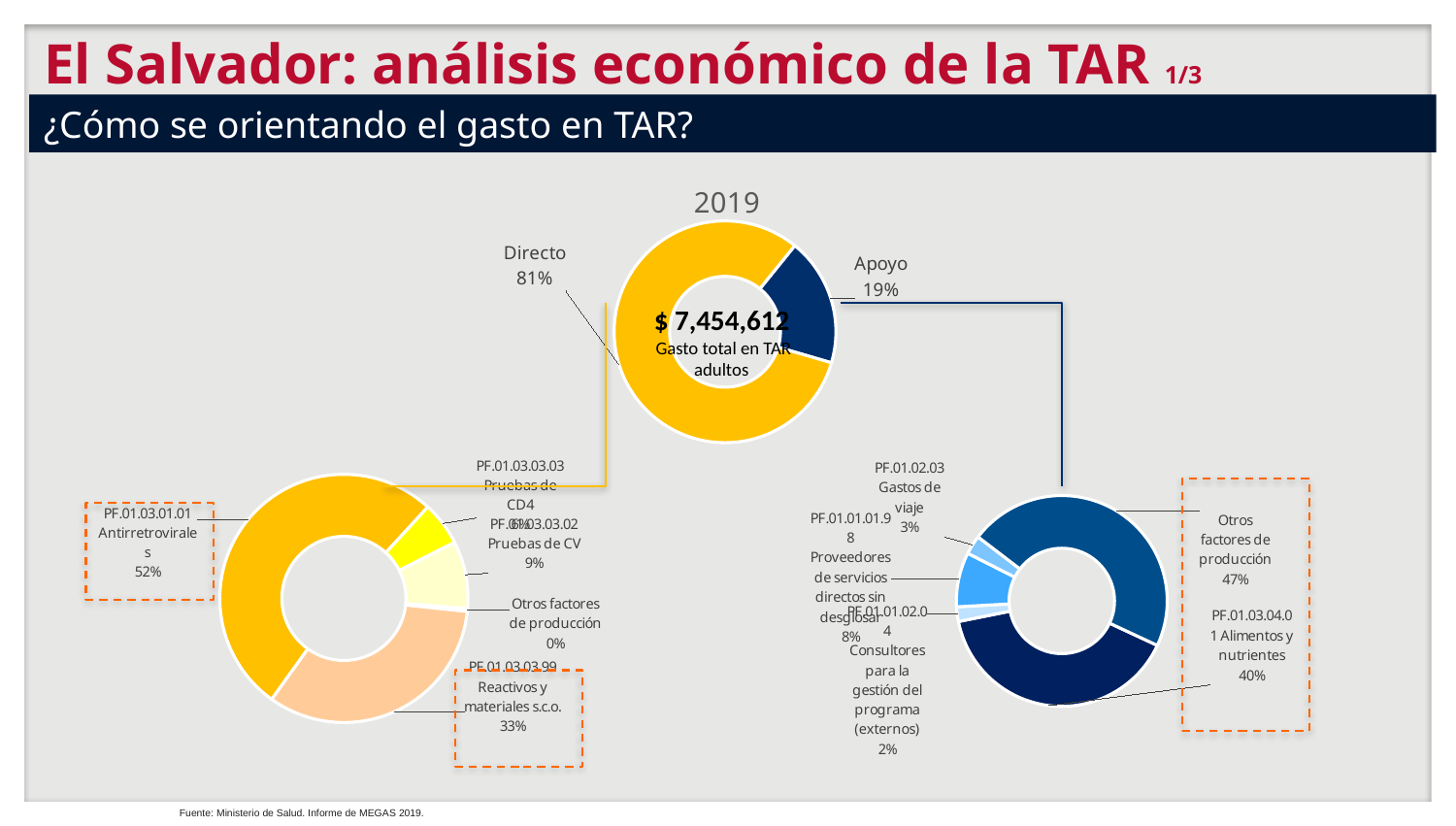
In the bottom-left donut chart, what share is Antirretrovirales (PF.01.03.01.01)? 52% In the top donut chart labelled 2019, what is the difference in percentage points between Directo and Apoyo? 62 In the bottom-right donut chart, what share is Alimentos y nutrientes (PF.01.03.04.01)? 40% What total amount is shown in the centre of the top donut chart labelled 2019? $ 7,454,612 In the bottom-right donut chart, which category has the smallest share? Consultores para la gestión del programa (externos) In the top donut chart labelled 2019, which is larger, Directo or Apoyo? Directo In the bottom-left donut chart, which category has the largest share? Antirretrovirales In the bottom-left donut chart, what share is Reactivos y materiales s.c.o. (PF.01.03.03.99)? 33% In the bottom-left donut chart, what share is Pruebas de CV (PF.01.03.03.02)? 9% In the bottom-right donut chart, what share is Otros factores de producción? 47% In the top donut chart labelled 2019, what share of spending is Directo? 81% In the top donut chart labelled 2019, what share of spending is Apoyo? 19%